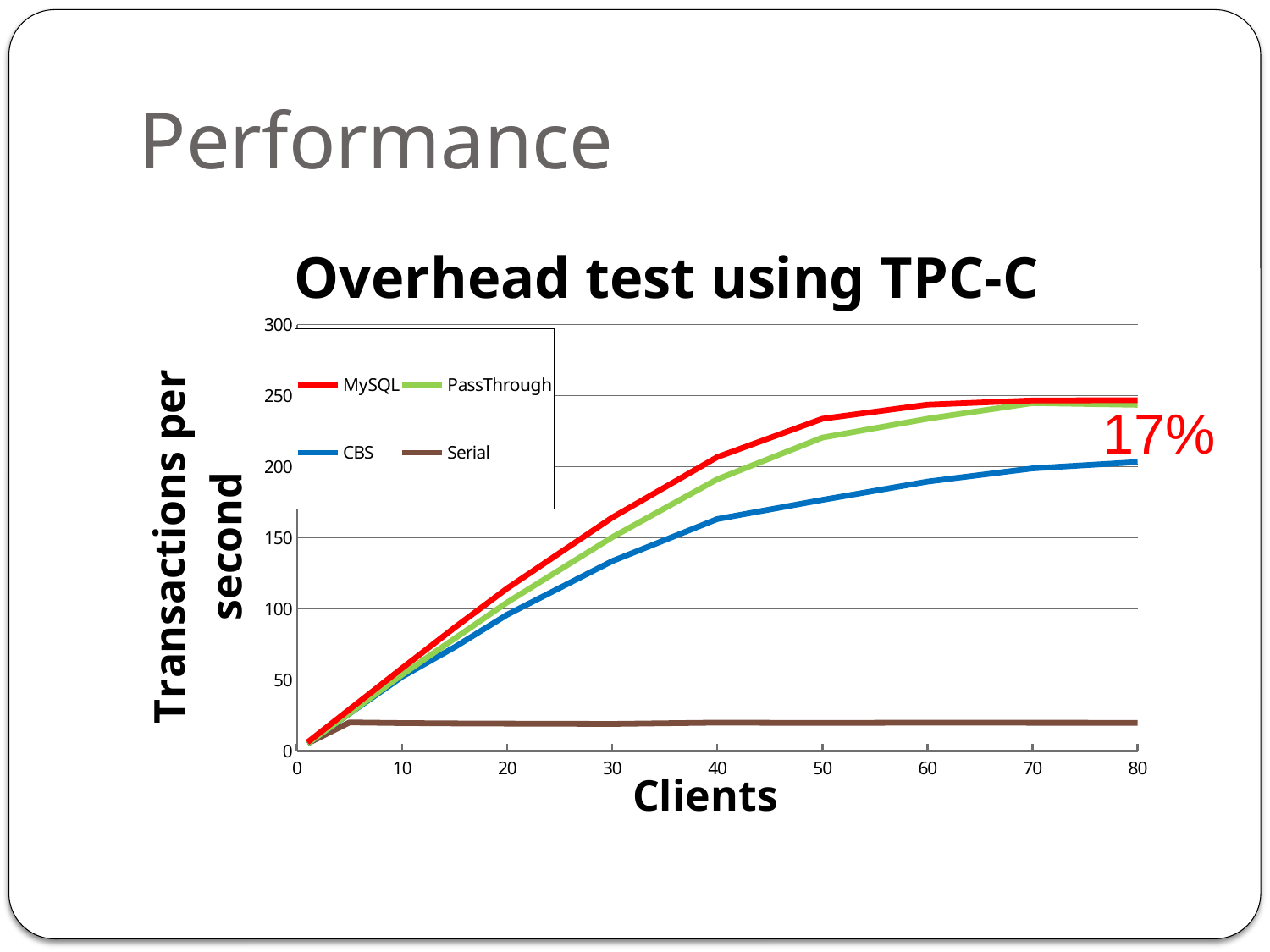
At 50 clients, which is larger: CBS or Serial? CBS What is the label of the y axis? Transactions per second What is the title of the chart? Overhead test using TPC-C Which series has the highest value at 80 clients? MySQL Does the MySQL series rise or fall as the number of clients increases from 0 to 80? rise Is the value for MySQL at 80 clients greater or less than 200? greater Which series has the lowest value at 80 clients? Serial Is the value for CBS at 40 clients greater or less than 150? greater What kind of chart is shown on the slide? line chart How many series does the legend list? 4 Is the value for PassThrough at 50 clients greater or less than 200? greater